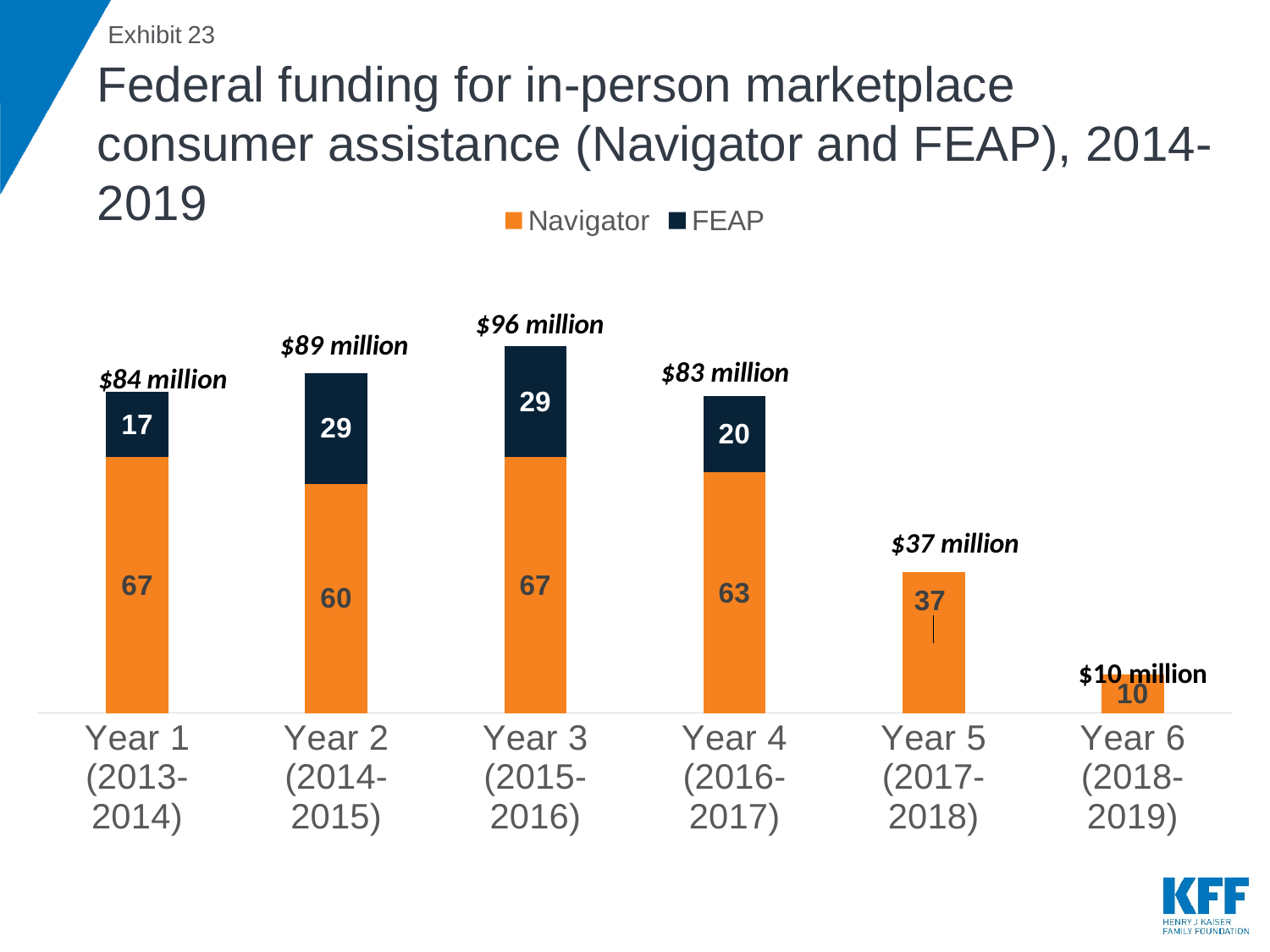
Which is larger, the Navigator value for Year 2 (2014-2015) or for Year 4 (2016-2017)? Year 4 (2016-2017) Which year has the highest total funding? Year 3 (2015-2016) What is the difference between the FEAP values for Year 3 (2015-2016) and Year 1 (2013-2014)? 12 What is the Navigator value for Year 5 (2017-2018)? 37 Do the total funding values rise or fall from Year 3 (2015-2016) to Year 6 (2018-2019)? Fall How many years (categories) are shown on the x axis? 6 What kind of chart is shown on the slide? Stacked bar chart What is the FEAP value for Year 2 (2014-2015)? 29 Which year has the lowest total funding? Year 6 (2018-2019) What is the total funding shown above the bar for Year 3 (2015-2016)? $96 million What is the Navigator value for Year 1 (2013-2014)? 67 How many series does the legend list? 2